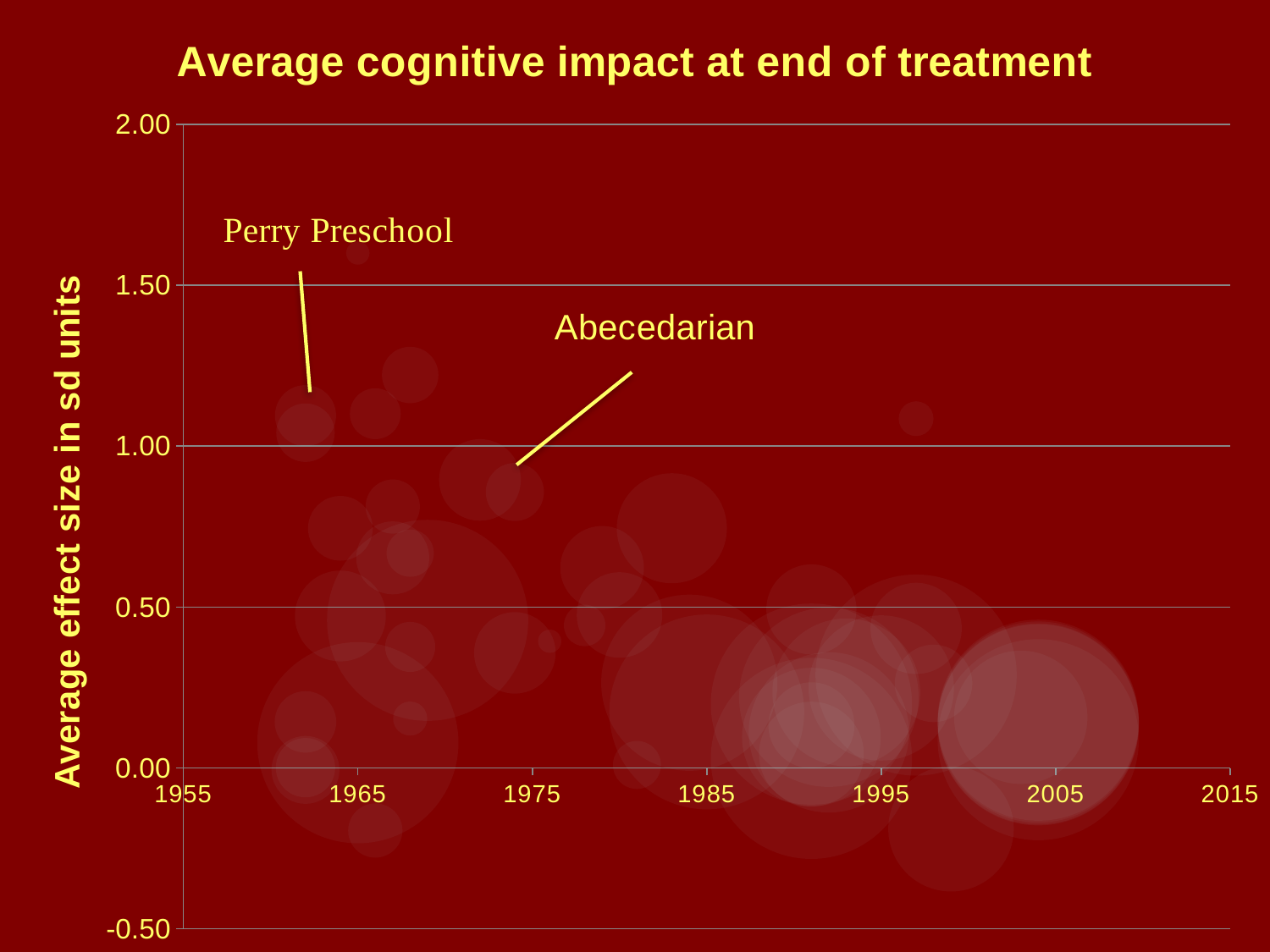
Is the average effect size for Perry Preschool greater or less than 0.50? greater Do the average effect sizes generally rise or fall as the years increase along the x axis? fall What is the title of the chart? Average cognitive impact at end of treatment Which of the two labelled programs appears earlier on the x axis, Perry Preschool or Abecedarian? Perry Preschool Is the average effect size for Abecedarian greater or less than 1.50? less What is the label on the vertical axis of the chart? Average effect size in sd units Is the average effect size for Perry Preschool greater or less than 1.50? less What kind of chart is shown on the slide? Bubble chart Which has the larger average effect size, Perry Preschool or Abecedarian? Perry Preschool